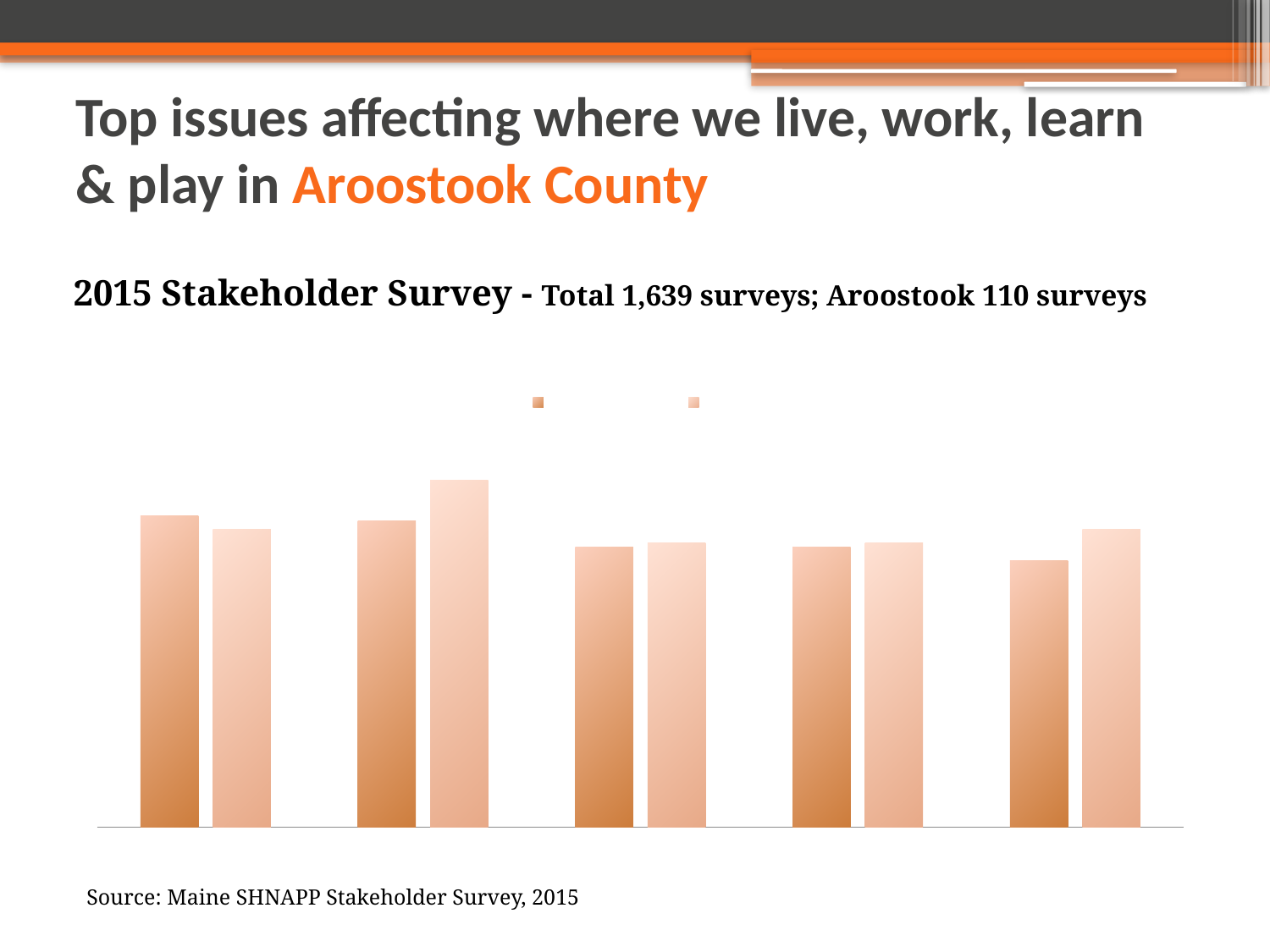
In the second group of bars from the left, is the darker bar or the lighter bar taller? the lighter bar In the fifth group of bars from the left, is the darker bar or the lighter bar taller? the lighter bar How many bars are plotted in total in the chart? 10 How many groups of bars are plotted in the chart? 5 How many surveys from Aroostook are mentioned in the slide subtitle? 110 surveys What source is cited below the chart? Maine SHNAPP Stakeholder Survey, 2015 Counting from the left, which group of bars contains the tallest bar in the chart? the second group What kind of chart is shown on the slide? bar chart In the first group of bars from the left, is the darker bar or the lighter bar taller? the darker bar Counting from the left, which group of bars contains the shortest bar in the chart? the fifth group How many series does the chart's legend show? 2